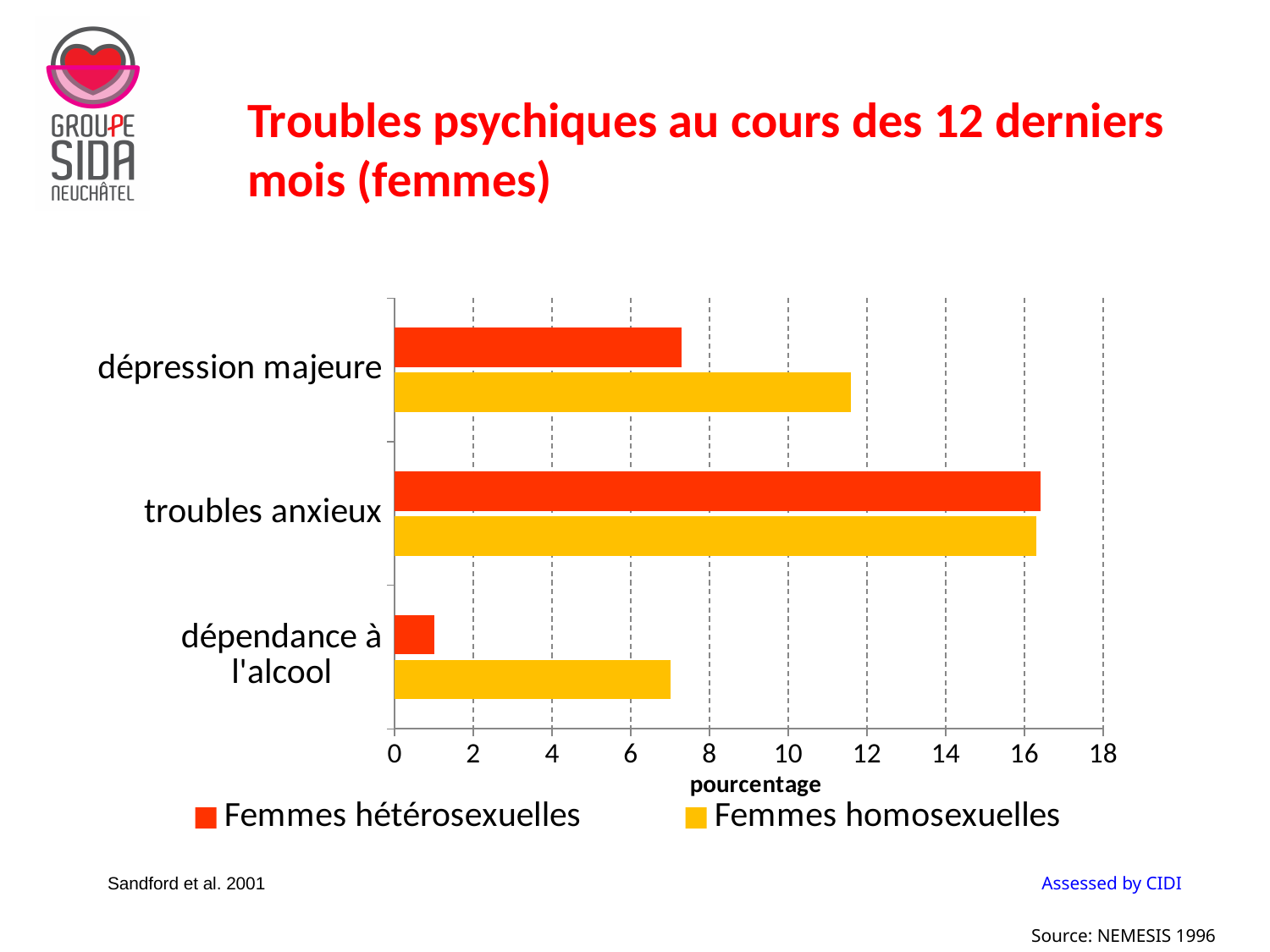
How many categories (disorders) are shown on the chart? 3 What is the label of the horizontal axis? pourcentage For dépendance à l'alcool, which series has the larger value: Femmes hétérosexuelles or Femmes homosexuelles? Femmes homosexuelles How many series does the legend list? 2 Is the value for Femmes homosexuelles in dépression majeure greater or less than 10? greater Which category has the lowest value for Femmes homosexuelles? dépendance à l'alcool Which category has the highest value for Femmes hétérosexuelles? troubles anxieux Is the value for Femmes hétérosexuelles in dépendance à l'alcool greater or less than 2? less What kind of chart is shown on the slide? bar chart For dépression majeure, which series has the larger value: Femmes hétérosexuelles or Femmes homosexuelles? Femmes homosexuelles Which category has the lowest value for Femmes hétérosexuelles? dépendance à l'alcool Is the value for Femmes hétérosexuelles in troubles anxieux greater or less than 16? greater